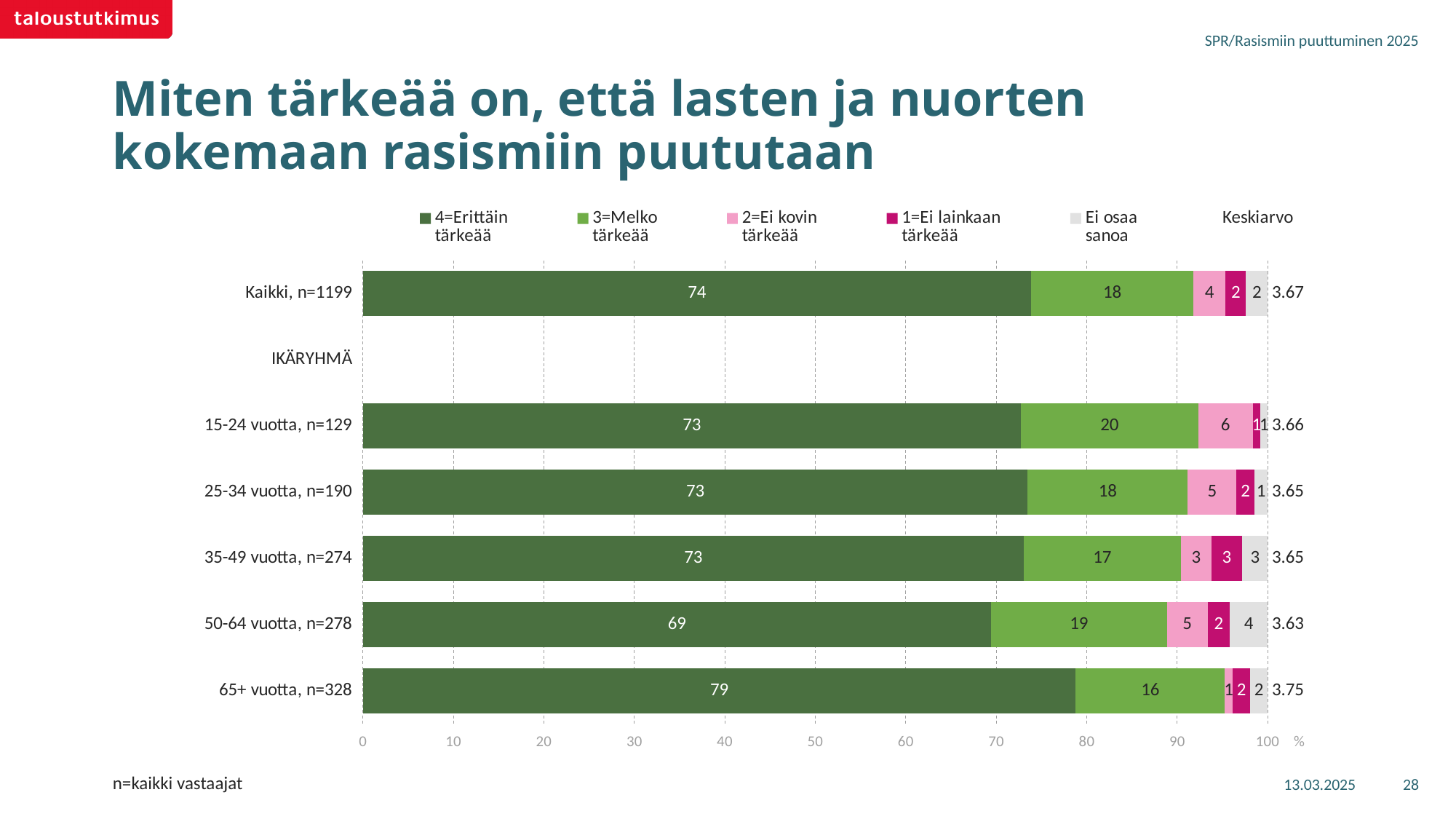
Which group has the highest share of 4=Erittäin tärkeää responses? 65+ vuotta, n=328 How many percentage points higher is the 4=Erittäin tärkeää share for 65+ vuotta than for 50-64 vuotta? 10 Which group has a larger share of 3=Melko tärkeää responses: 15-24 vuotta or 65+ vuotta? 15-24 vuotta Which group has the lowest share of 4=Erittäin tärkeää responses? 50-64 vuotta, n=278 What percentage of the 65+ vuotta, n=328 group answered 4=Erittäin tärkeää? 79 Which group has the highest Keskiarvo value? 65+ vuotta, n=328 What percentage of the 15-24 vuotta, n=129 group answered 2=Ei kovin tärkeää? 6 What is the total of the stacked bar for Kaikki, n=1199 (74 + 18 + 4 + 2 + 2)? 100 What type of chart is shown on the slide? Stacked bar chart What is the Keskiarvo (mean) shown for the 50-64 vuotta, n=278 group? 3.63 How many bars (respondent groups) are plotted in the chart? 6 What percentage of the 50-64 vuotta, n=278 group answered Ei osaa sanoa? 4